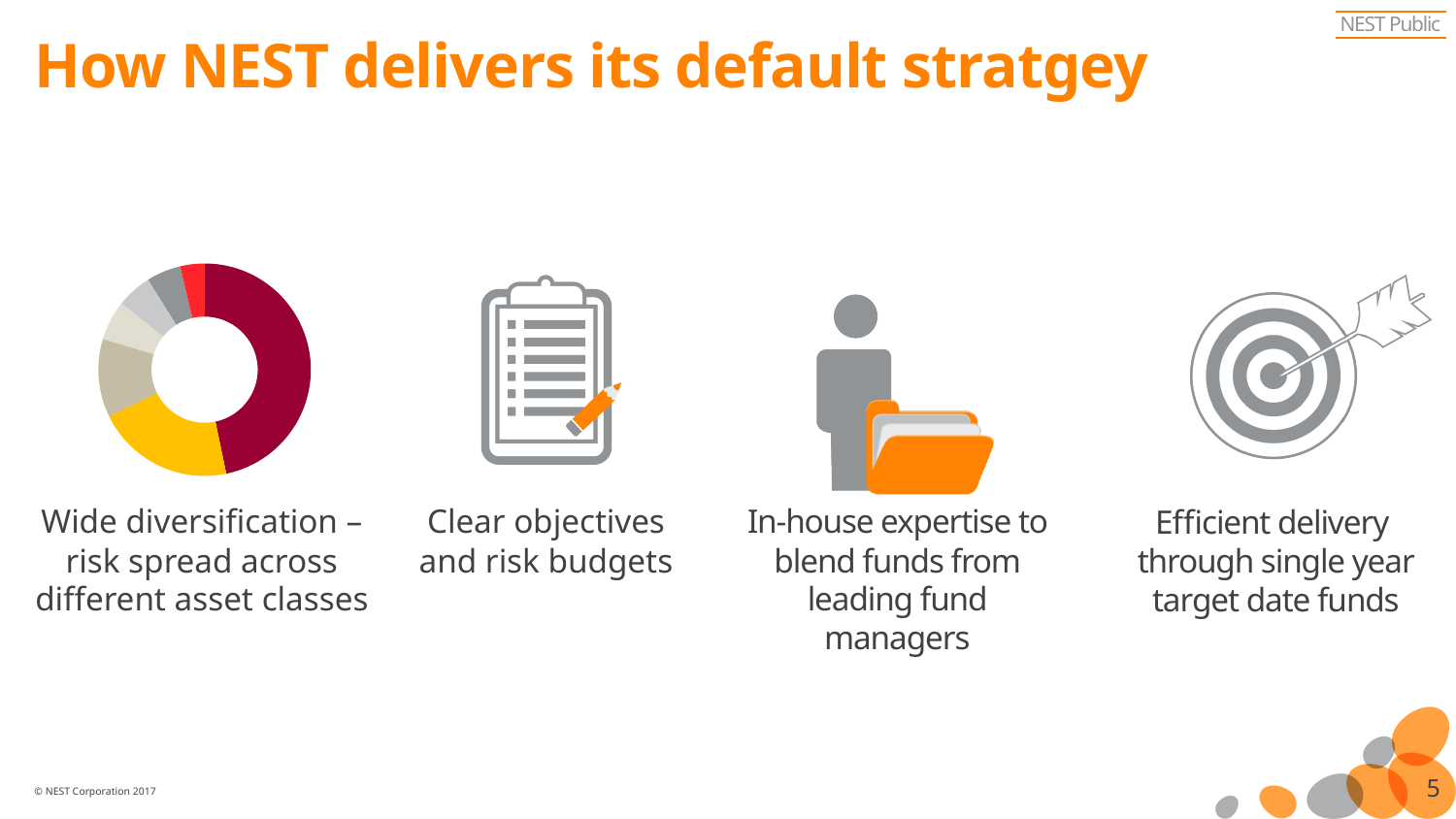
What kind of chart is shown on the left of the slide, above the text 'Wide diversification'? Doughnut (pie) chart Does the doughnut chart on the left of the slide show a legend or data labels? No In the doughnut chart on the left of the slide, which colour slice is the largest? Dark red